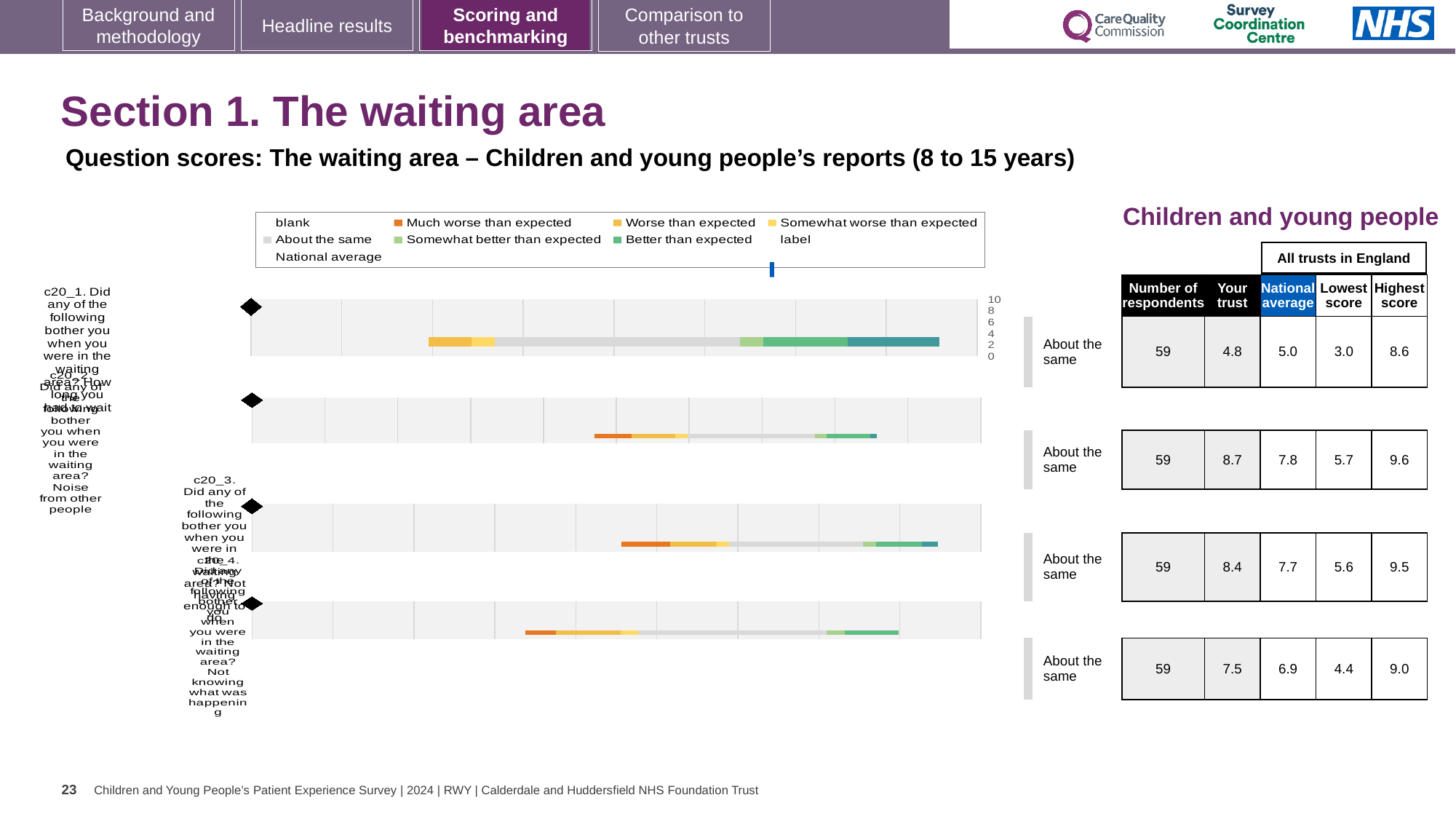
In the table, what is the 'Your trust' score for the first (top) question row? 4.8 In the table, what is the national average for the second question row? 7.8 How many separate bar charts are shown on the slide? 4 In the third question row of the table, which is larger: the 'Your trust' score or the national average? Your trust (8.4) How many entries does the chart legend list? 9 What kind of chart is used to show the expected ranges for the waiting area questions? bar chart In the table, how many respondents are listed for the fourth (bottom) question row? 59 Which question row in the table has the highest 'Your trust' score? the second row (8.7) In the second question row of the table, what is the difference between the 'Your trust' score and the national average? 0.9 What rating label is shown next to each of the four bar charts? About the same What colour does the legend use for 'Much worse than expected'? orange Which question row in the table has the lowest 'Your trust' score? the first row (4.8)